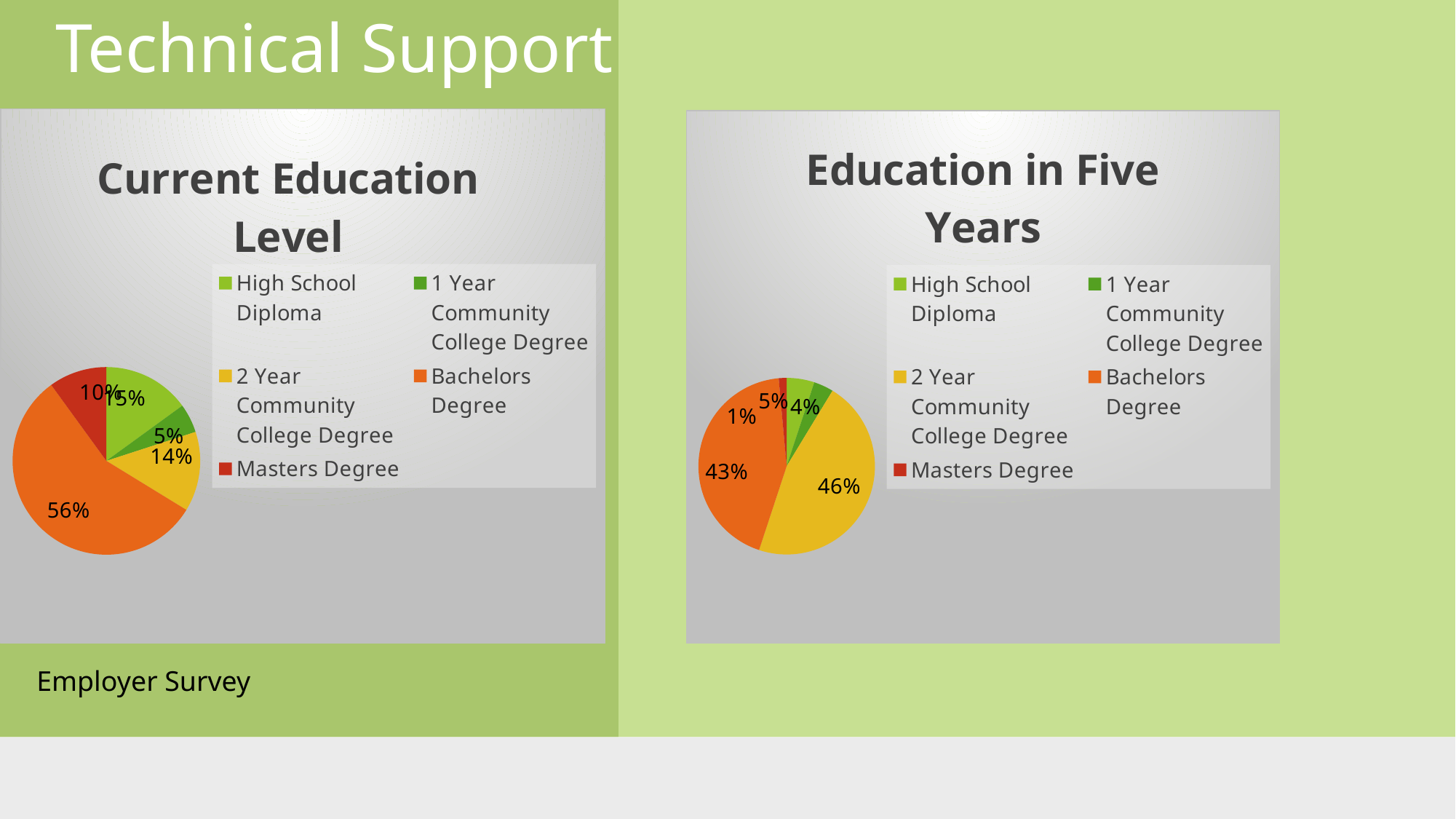
In the Education in Five Years chart, what percentage is shown for a Bachelors Degree? 43% In the Education in Five Years chart, which category has the smallest share? Masters Degree What type of chart is the Education in Five Years chart? Pie chart What is the title of the chart on the left side of the slide? Current Education Level In the Current Education Level chart, what percentage holds a Masters Degree? 10% In the Current Education Level chart, what percentage holds a High School Diploma? 15% In the Education in Five Years chart, which is larger: the share for 2 Year Community College Degree or for Bachelors Degree? 2 Year Community College Degree In the Current Education Level chart, what is the difference between the Bachelors Degree share and the 2 Year Community College Degree share? 42% In the Education in Five Years chart, what percentage is shown for a 2 Year Community College Degree? 46% In the Current Education Level chart, which category has the largest share? Bachelors Degree In the Current Education Level chart, what percentage holds a Bachelors Degree? 56% How many categories does the legend of the Current Education Level chart list? 5